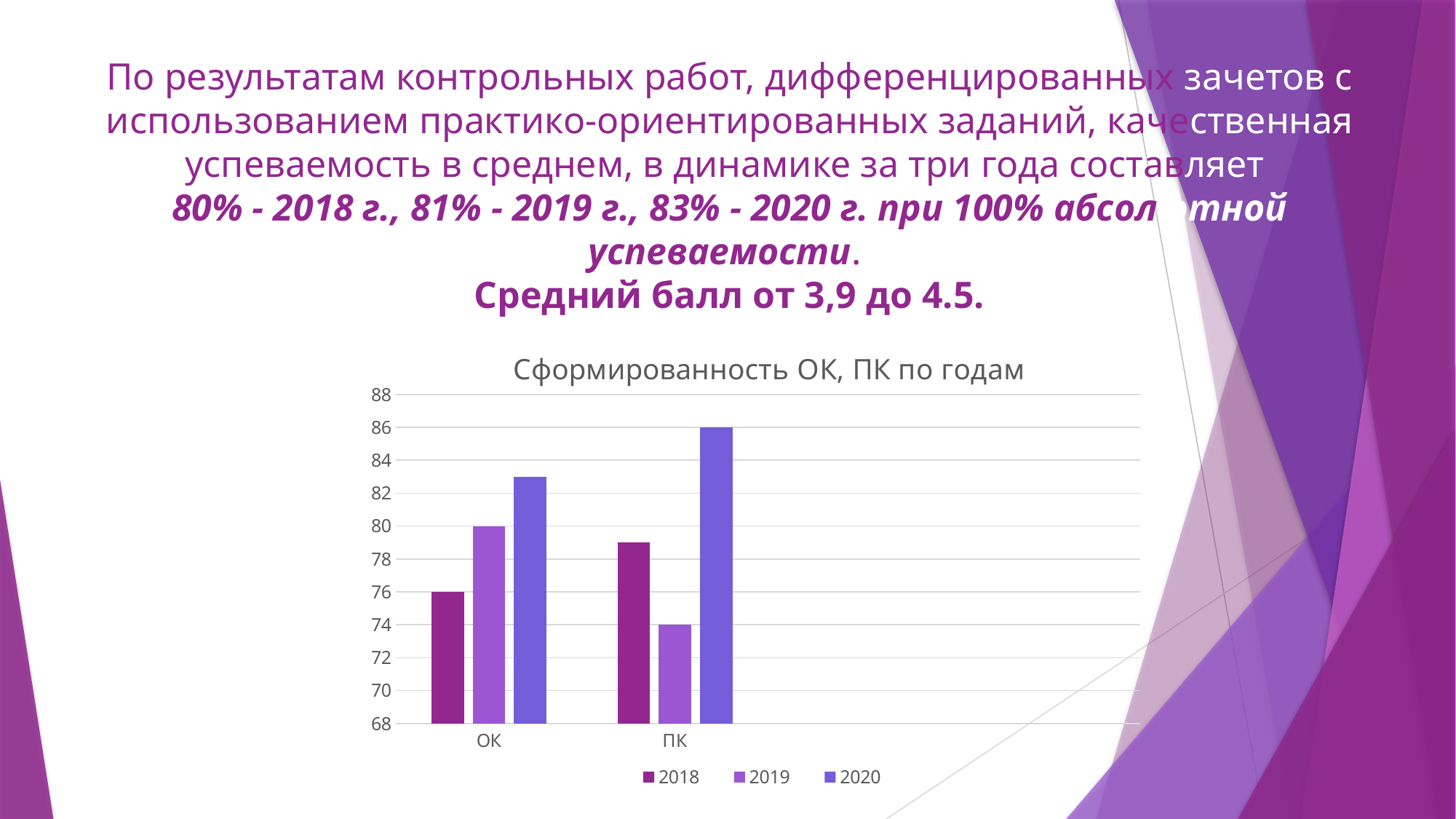
Is the value for ОК in 2020 greater or less than 82? greater Do the values for ОК rise or fall from 2018 to 2020? rise Which bar is the shortest in the chart? ПК in 2019 What is the value for ОК in 2019? 80 Is the value for ПК in 2018 greater or less than 80? less Which bar is the tallest in the chart? ПК in 2020 Which is larger, the 2019 value for ОК or the 2019 value for ПК? ОК What is the difference between the ПК values for 2020 and 2019? 12 What is the value for ОК in 2018? 76 What is the value for ПК in 2020? 86 What is the value for ПК in 2019? 74 How many series does the legend list? 3